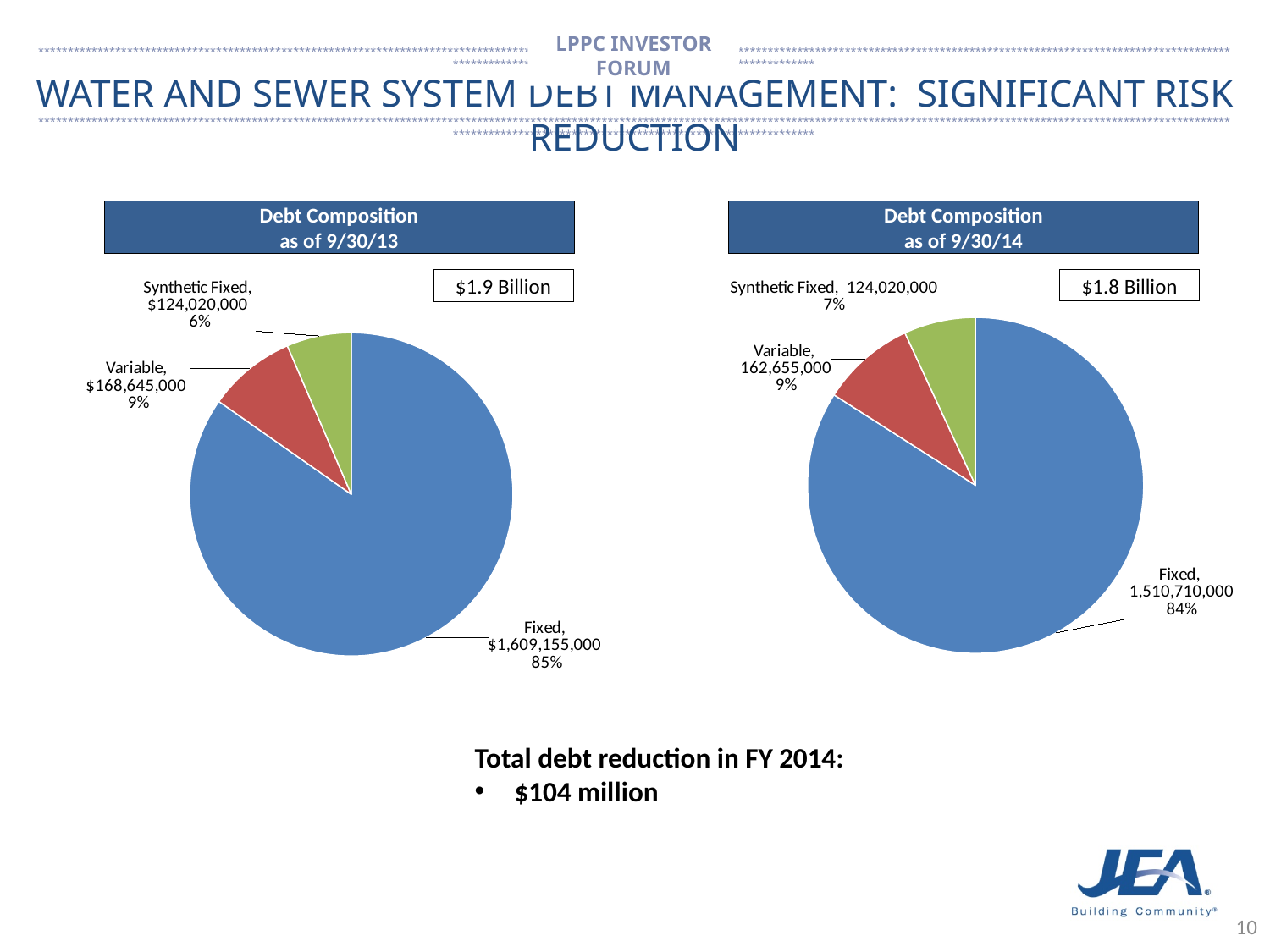
In the 'Debt Composition as of 9/30/13' chart, which is larger, Variable or Synthetic Fixed? Variable In the 'Debt Composition as of 9/30/13' chart, what is the value for Variable? $168,645,000 In the 'Debt Composition as of 9/30/14' chart, what is the difference between the Variable and Synthetic Fixed values? 38,635,000 How many slices does the 'Debt Composition as of 9/30/13' chart have? 3 What kind of chart is the 'Debt Composition as of 9/30/14' chart? Pie chart In the 'Debt Composition as of 9/30/13' chart, which category is the smallest? Synthetic Fixed In the 'Debt Composition as of 9/30/13' chart, what is the value for Fixed? $1,609,155,000 In the 'Debt Composition as of 9/30/14' chart, what is the value for Variable? 162,655,000 In the 'Debt Composition as of 9/30/14' chart, which category is the largest? Fixed In the 'Debt Composition as of 9/30/14' chart, what is the value for Fixed? 1,510,710,000 In the 'Debt Composition as of 9/30/13' chart, what share of the pie is Synthetic Fixed? 6% In the 'Debt Composition as of 9/30/14' chart, what share of the pie is Fixed? 84%